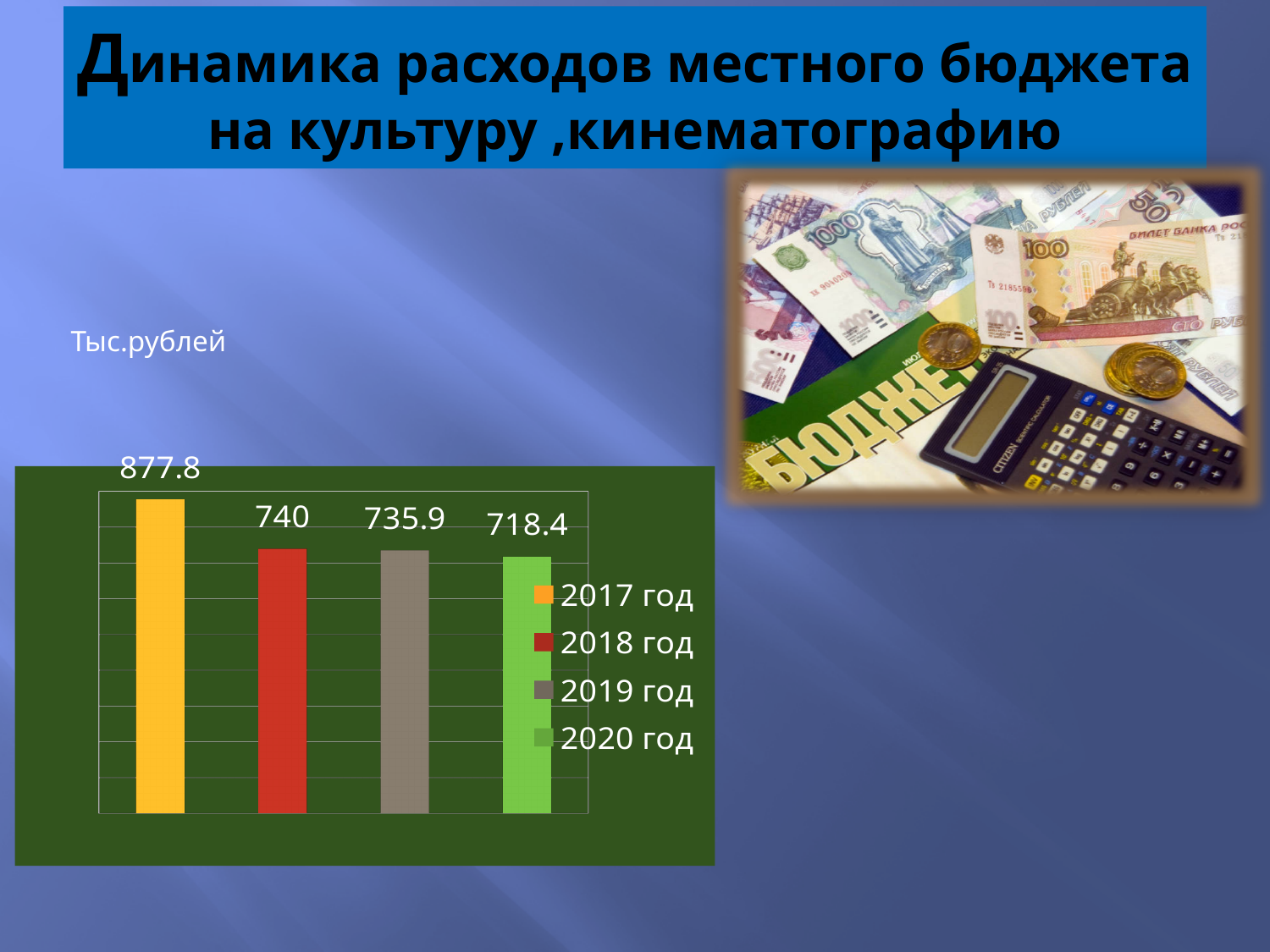
What kind of chart is shown on the slide? Bar chart What is the value for 2018 год? 740 Which year has the lowest value? 2020 год Which year has the highest value? 2017 год Which is larger, the value for 2017 год or the value for 2020 год? 2017 год How many bars are plotted in the chart? 4 How many entries does the legend list? 4 What is the difference between the values for 2017 год and 2018 год? 137.8 What is the value for 2020 год? 718.4 What is the value for 2017 год? 877.8 What is the value for 2019 год? 735.9 What is the difference between the values for 2019 год and 2020 год? 17.5